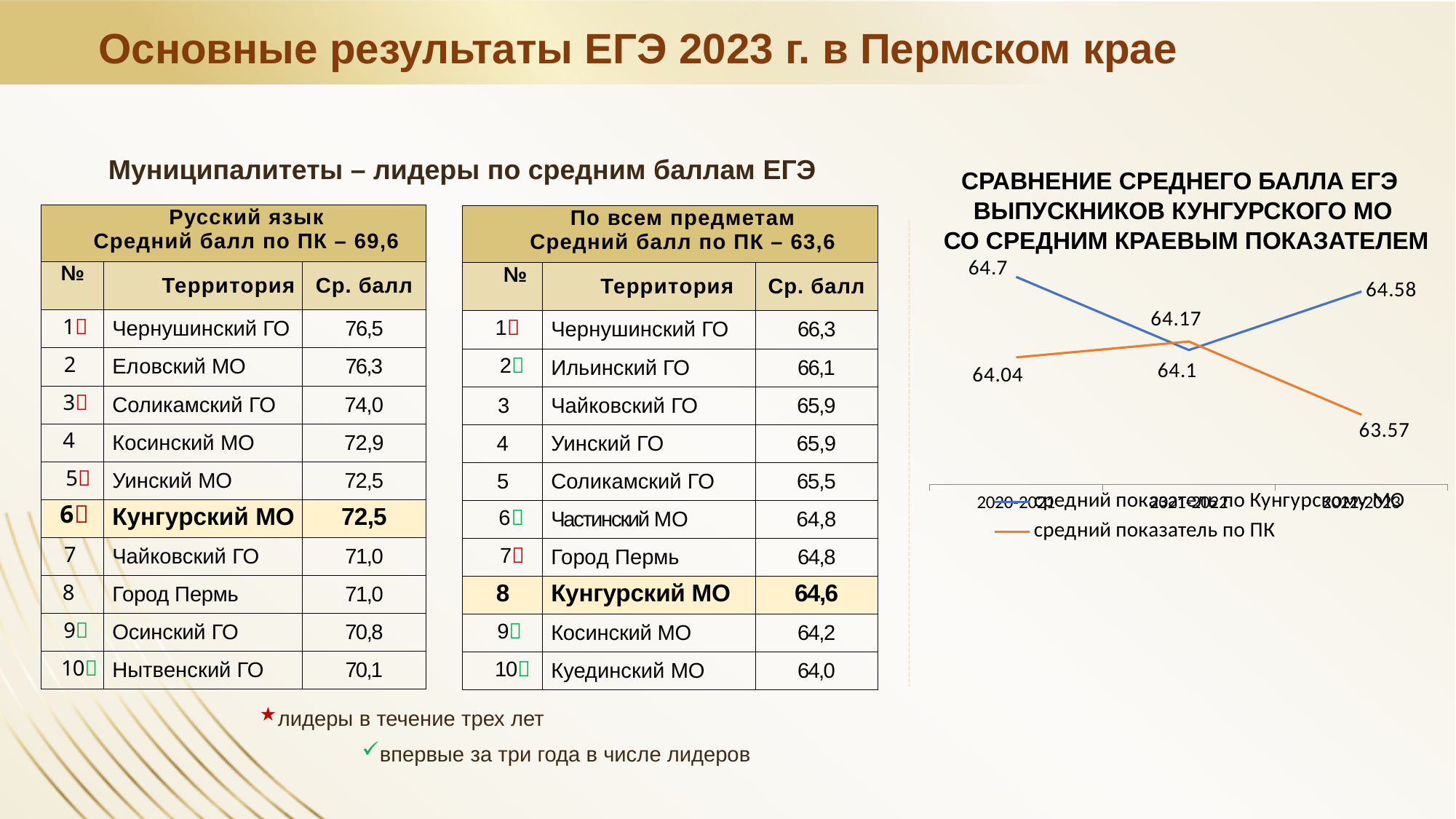
In the line chart, what is the value for Кунгурский МО in 2020-2021? 64.7 In the line chart, what is the value for ПК in 2022-2023? 63.57 In the line chart, what is the value for ПК (Пермский край) in 2020-2021? 64.04 In the line chart, what is the difference between the Кунгурский МО value and the ПК value in 2022-2023? 1.01 In the line chart, which period has the highest value for ПК? 2021-2022 How many points are plotted for each series in the line chart? 3 How many series does the legend of the line chart list? 2 In the line chart, which is larger in 2022-2023: the value for Кунгурский МО or the value for ПК? Кунгурский МО What kind of chart is shown on the right side of the slide? line chart In the line chart, which period has the lowest value for Кунгурский МО? 2021-2022 In the line chart, what is the value for ПК in 2021-2022? 64.17 In the line chart, what is the value for Кунгурский МО in 2022-2023? 64.58